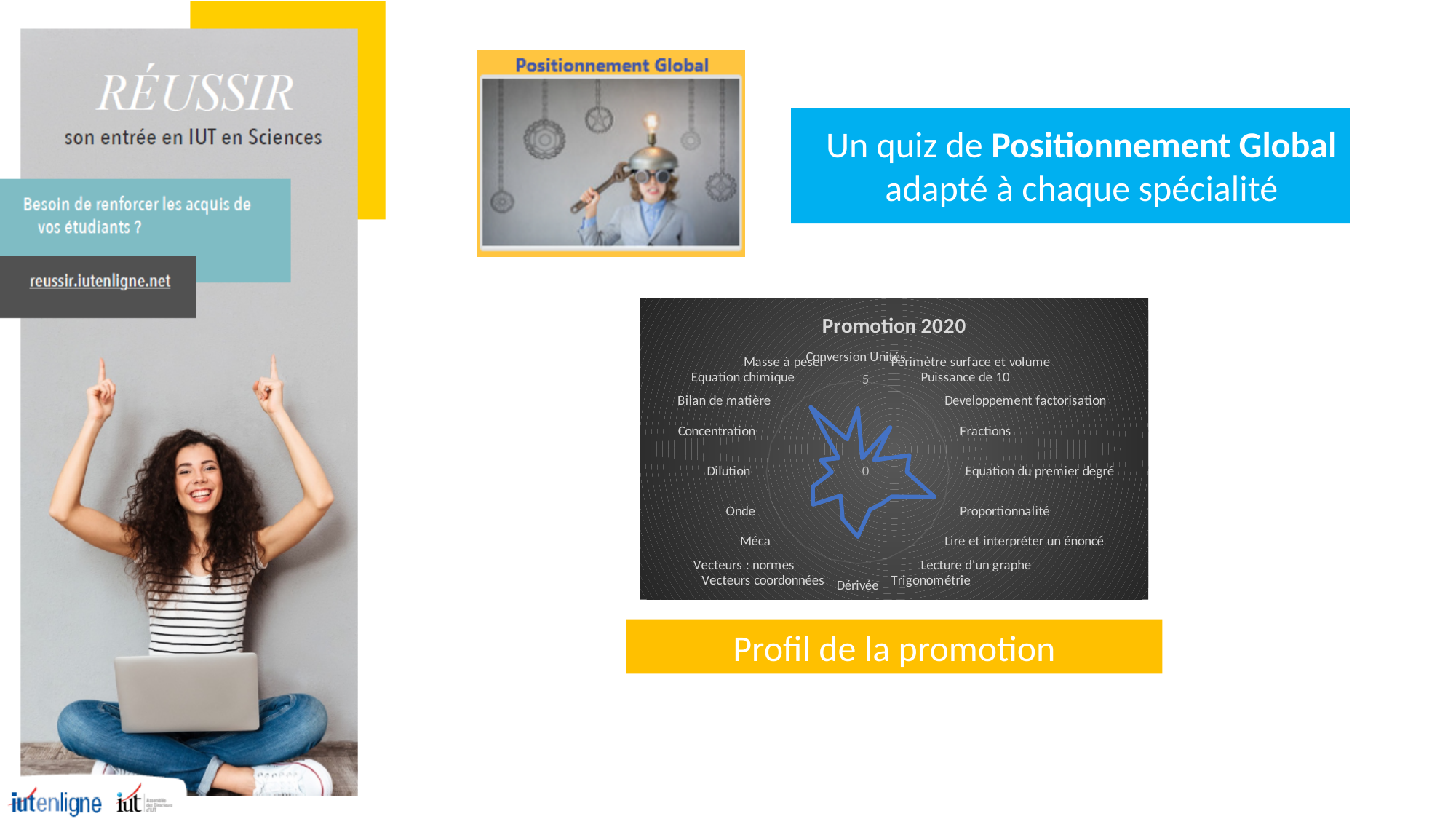
What is the title of the chart on the slide? Promotion 2020 What is the highest tick value printed on the radial axis of the "Promotion 2020" chart? 5 In the "Promotion 2020" chart, is the value for Concentration greater or less than 5? less How many categories (axes) does the "Promotion 2020" radar chart have? 20 In the "Promotion 2020" chart, is the value for Dérivée greater or less than 5? less What kind of chart is shown under the title "Promotion 2020"? radar chart In the "Promotion 2020" chart, is the value for Puissance de 10 greater or less than 5? less